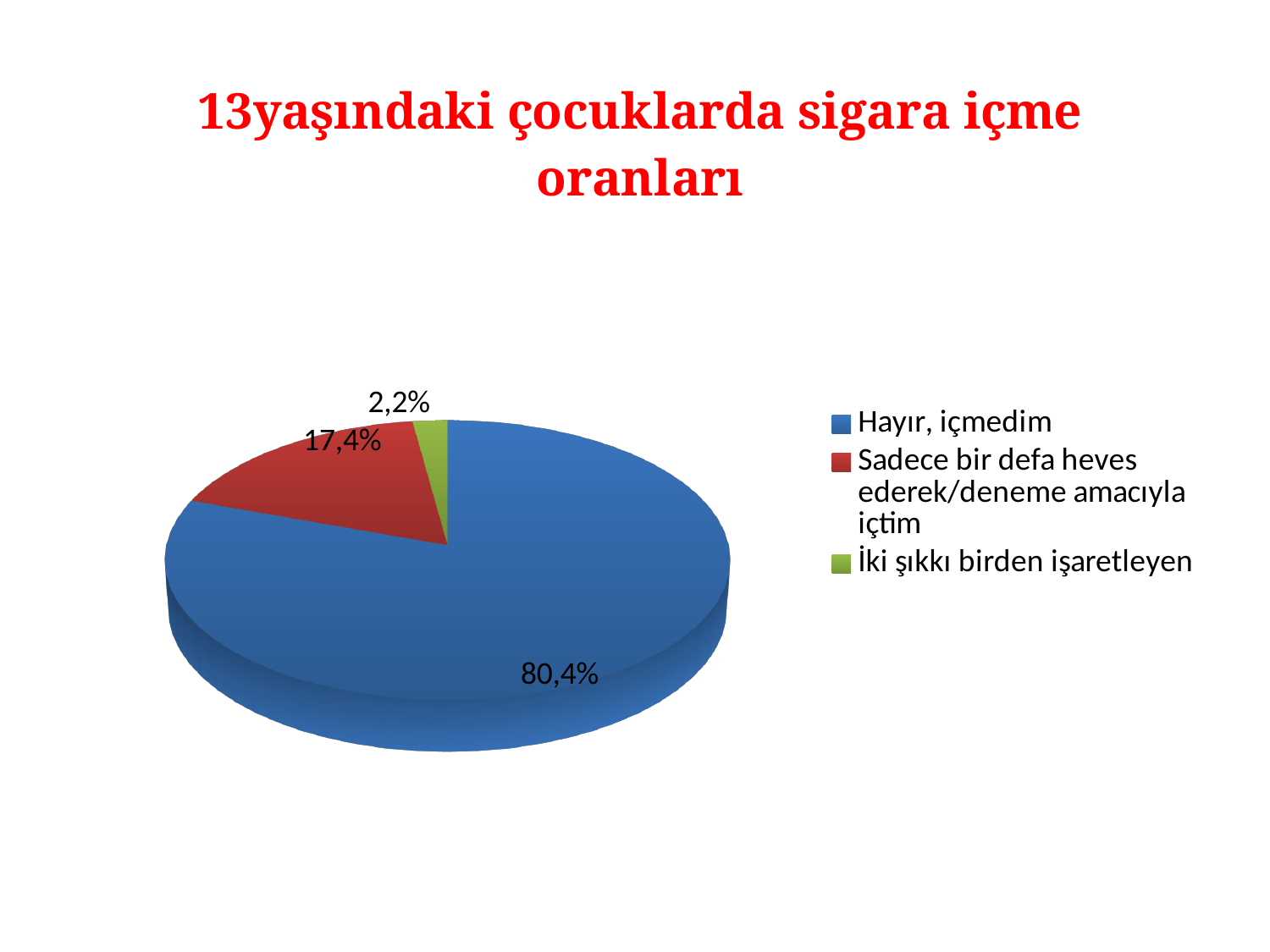
How many slices does the pie chart have? 3 What is the title of the slide? 13yaşındaki çocuklarda sigara içme oranları Which is larger: the slice for "Sadece bir defa heves ederek/deneme amacıyla içtim" or the slice for "İki şıkkı birden işaretleyen"? Sadece bir defa heves ederek/deneme amacıyla içtim What kind of chart is shown on the slide? Pie chart What colour is the slice for "Hayır, içmedim"? Blue What is the difference between the "Hayır, içmedim" slice and the "Sadece bir defa heves ederek/deneme amacıyla içtim" slice? 63,0% What percentage of the pie is labelled for "Hayır, içmedim"? 80,4% What value is shown for the slice "İki şıkkı birden işaretleyen"? 2,2% What value is shown for the slice "Sadece bir defa heves ederek/deneme amacıyla içtim"? 17,4% How many entries does the legend list? 3 Which category has the smallest slice of the pie? İki şıkkı birden işaretleyen Which category has the largest slice of the pie? Hayır, içmedim